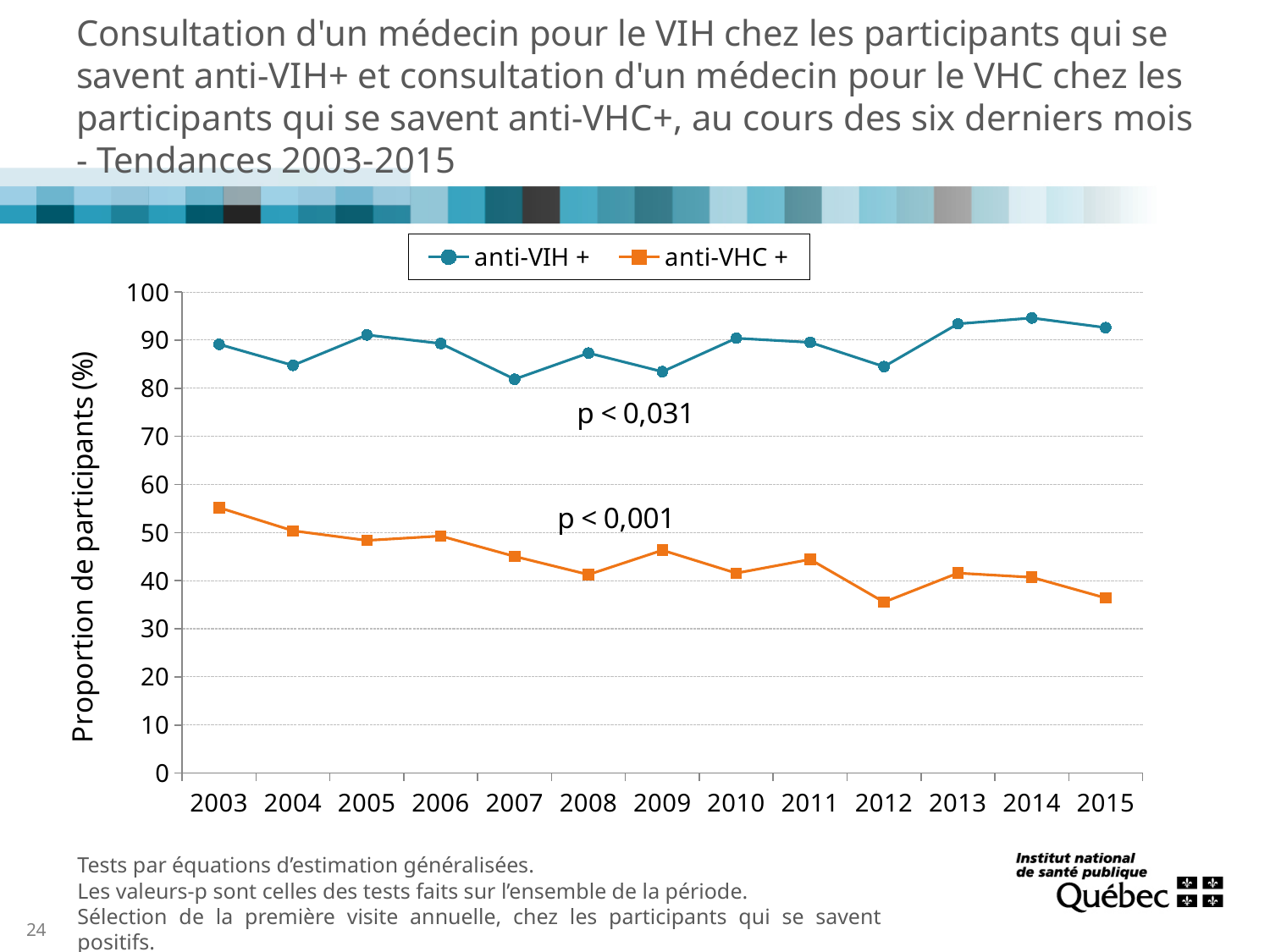
Which series has the highest value in 2003? anti-VIH + How many series does the legend list? 2 Is the value for anti-VHC + in 2012 greater or less than 40? less What p-value is printed next to the anti-VHC + line? p < 0,001 Does the anti-VHC + series generally rise or fall from 2003 to 2015? fall What is the label of the y axis? Proportion de participants (%) How many years are plotted along the x axis? 13 In which year is the anti-VHC + series at its highest? 2003 Is the value for anti-VIH + in 2014 greater or less than 90? greater Is the value for anti-VIH + in 2007 greater or less than 90? less What kind of chart is shown on the slide? line chart